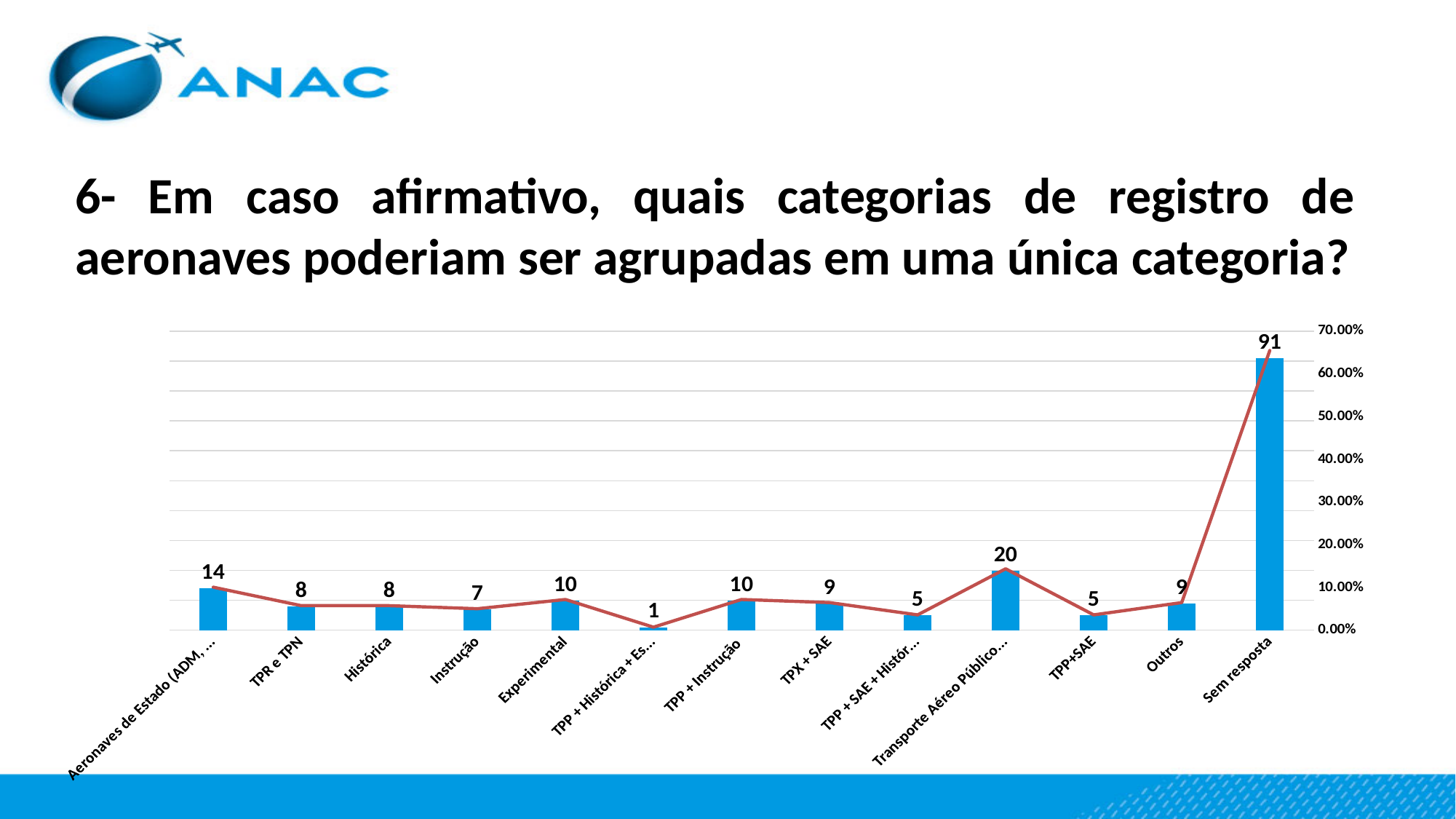
What is the value for Histórica? 8 What is the difference between the values for Aeronaves de Estado (ADM, ...) and Instrução? 7 Which is larger, the value for TPX + SAE or the value for TPP+SAE? TPX + SAE How many categories are shown on the x axis? 13 What is the value for Sem resposta? 91 Is the red line value for Sem resposta greater or less than 60.00%? greater Which category has the lowest value? TPP + Histórica + Es... What is the value for Outros? 9 What is the difference between the values for Sem resposta and Transporte Aéreo Público...? 71 What kind of chart is used for the blue data series? bar chart What is the value for Experimental? 10 Which category has the highest value? Sem resposta